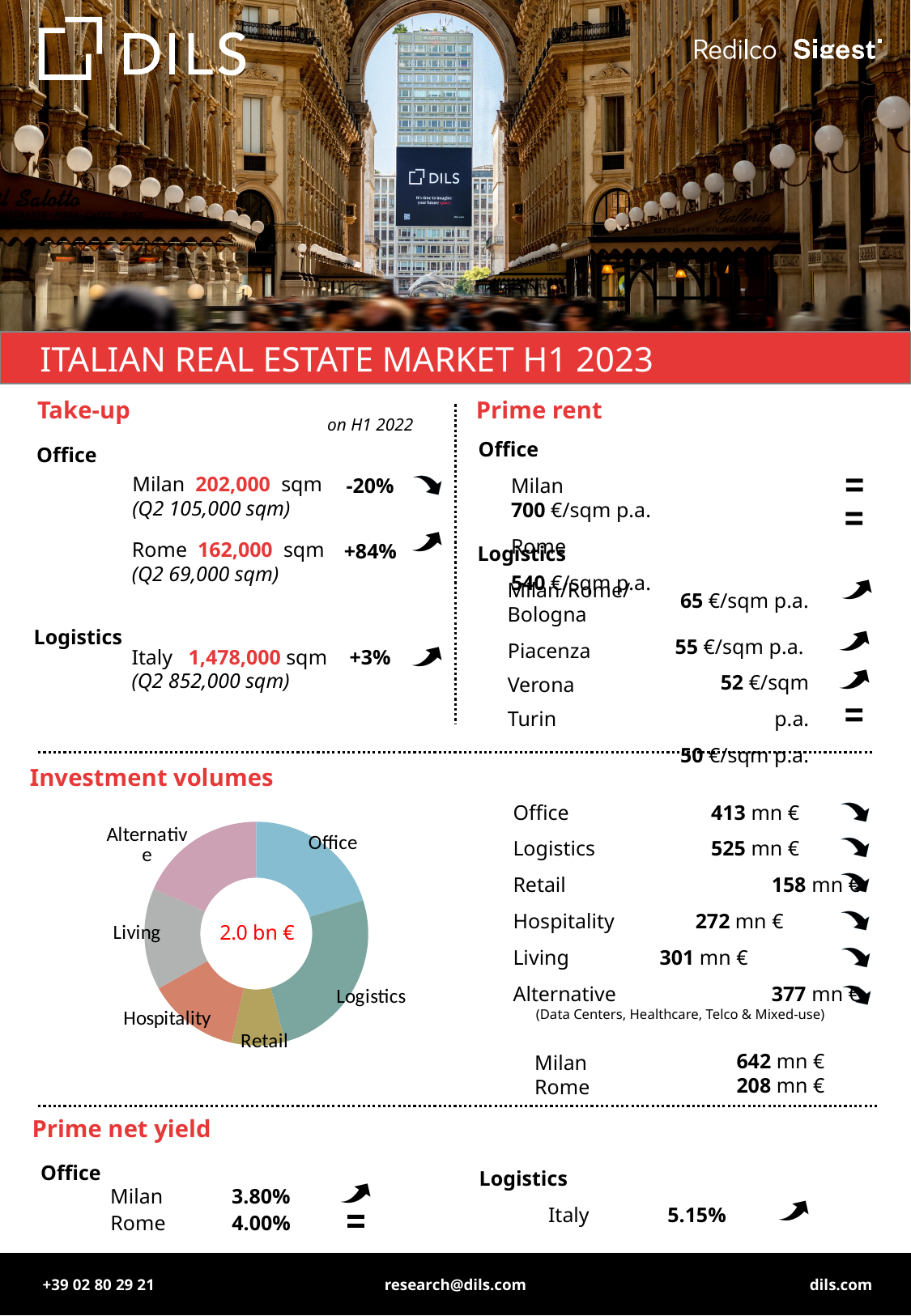
What kind of chart is shown under "Investment volumes"? Pie chart (donut) In the Investment volumes chart, what is the investment volume for Alternative? 377 mn € Which category has the largest slice in the Investment volumes donut chart? Logistics In the Investment volumes chart, what is the investment volume for Hospitality? 272 mn € In the Investment volumes chart, what is the difference between Logistics and Retail? 367 mn € Which category is shown in pink in the Investment volumes donut chart? Alternative In the Investment volumes chart, which is larger: Living or Hospitality? Living How many categories does the Investment volumes donut chart show? 6 Which category has the smallest slice in the Investment volumes donut chart? Retail In the Investment volumes chart, what is the investment volume for Office? 413 mn € What total value is printed in the centre of the Investment volumes donut chart? 2.0 bn € In the Investment volumes chart, what is the investment volume for Logistics? 525 mn €